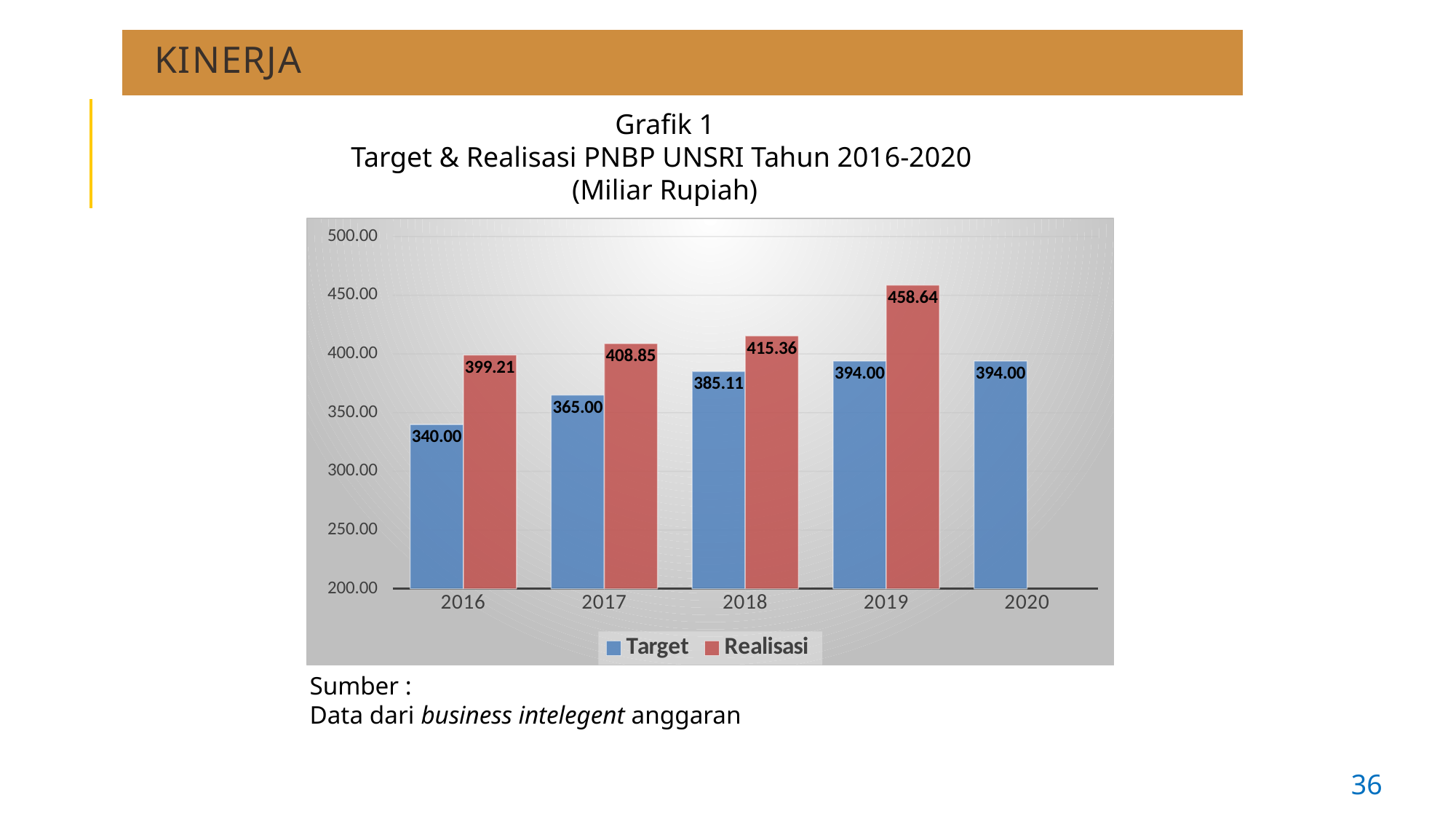
How many series does the legend list? 2 Does the Realisasi value rise or fall from 2016 to 2019? Rise What is the Target value for 2020? 394.00 How many years are shown on the x axis? 5 Which is larger in 2016, the Target or the Realisasi value? Realisasi What is the Target value for 2016? 340.00 In which year is the Realisasi value highest? 2019 What is the difference between Realisasi and Target in 2018? 30.25 What kind of chart is shown on the slide? Bar chart What is the Realisasi value for 2019? 458.64 In which year is the Target value lowest? 2016 What is the Realisasi value for 2017? 408.85